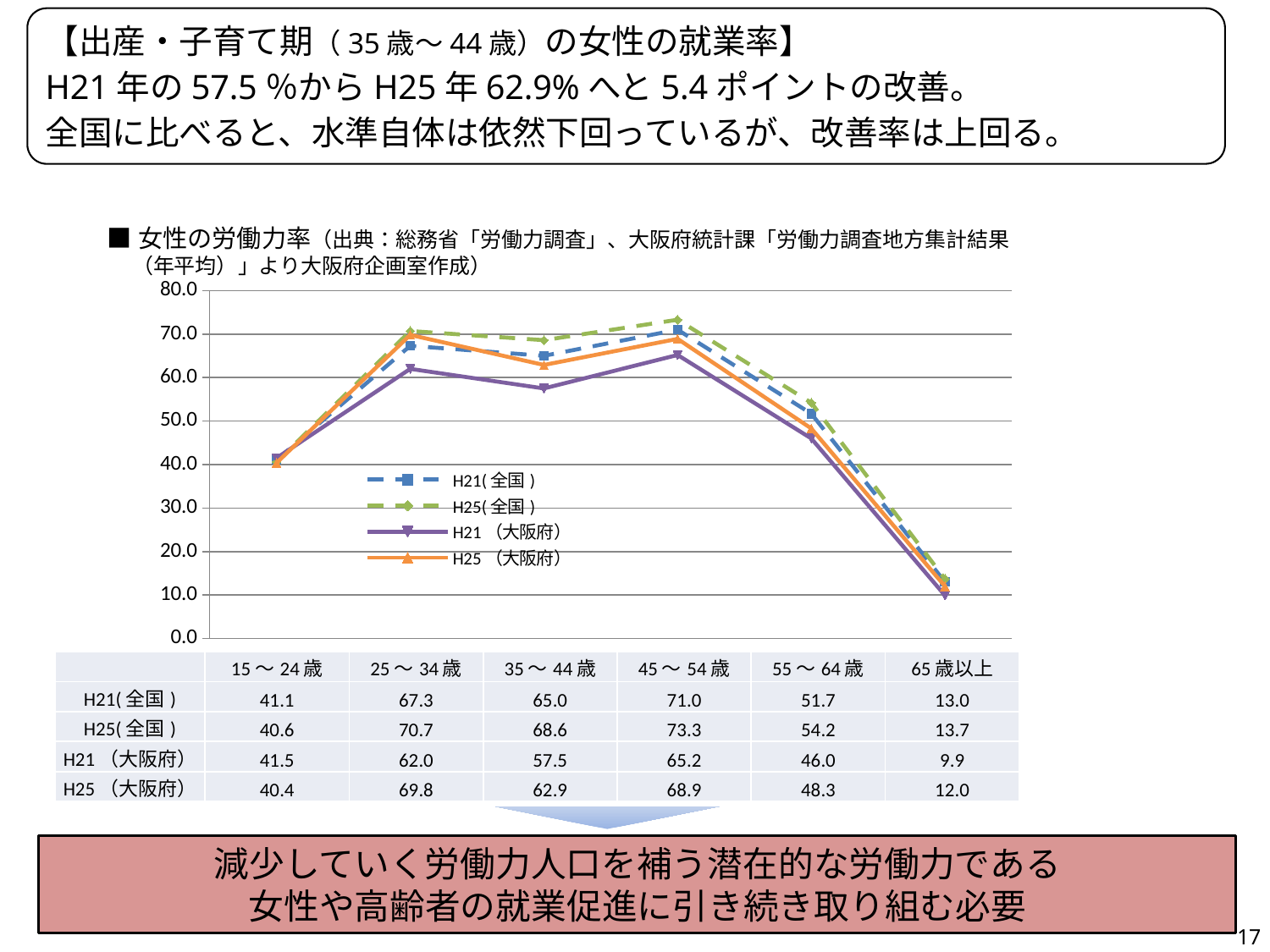
Which age group has the lowest value for the H21（大阪府） series? 65歳以上 In the 25～34歳 age group, which is larger: H25(全国) or H25（大阪府）? H25(全国) What is the value for H21(全国) in the 45～54歳 age group? 71.0 What kind of chart is shown on the slide? line chart How many series does the legend list? 4 What is the value for H25（大阪府） in the 35～44歳 age group? 62.9 What is the difference between H25（大阪府） and H21（大阪府） in the 35～44歳 age group? 5.4 How many age groups are plotted on the x axis? 6 Do the values for H25(全国) rise or fall from the 45～54歳 group to the 65歳以上 group? fall Which age group has the highest value for the H25(全国) series? 45～54歳 Is the value for H21（大阪府） in the 55～64歳 age group greater or less than 50.0? less What is the value for H21（大阪府） in the 65歳以上 age group? 9.9